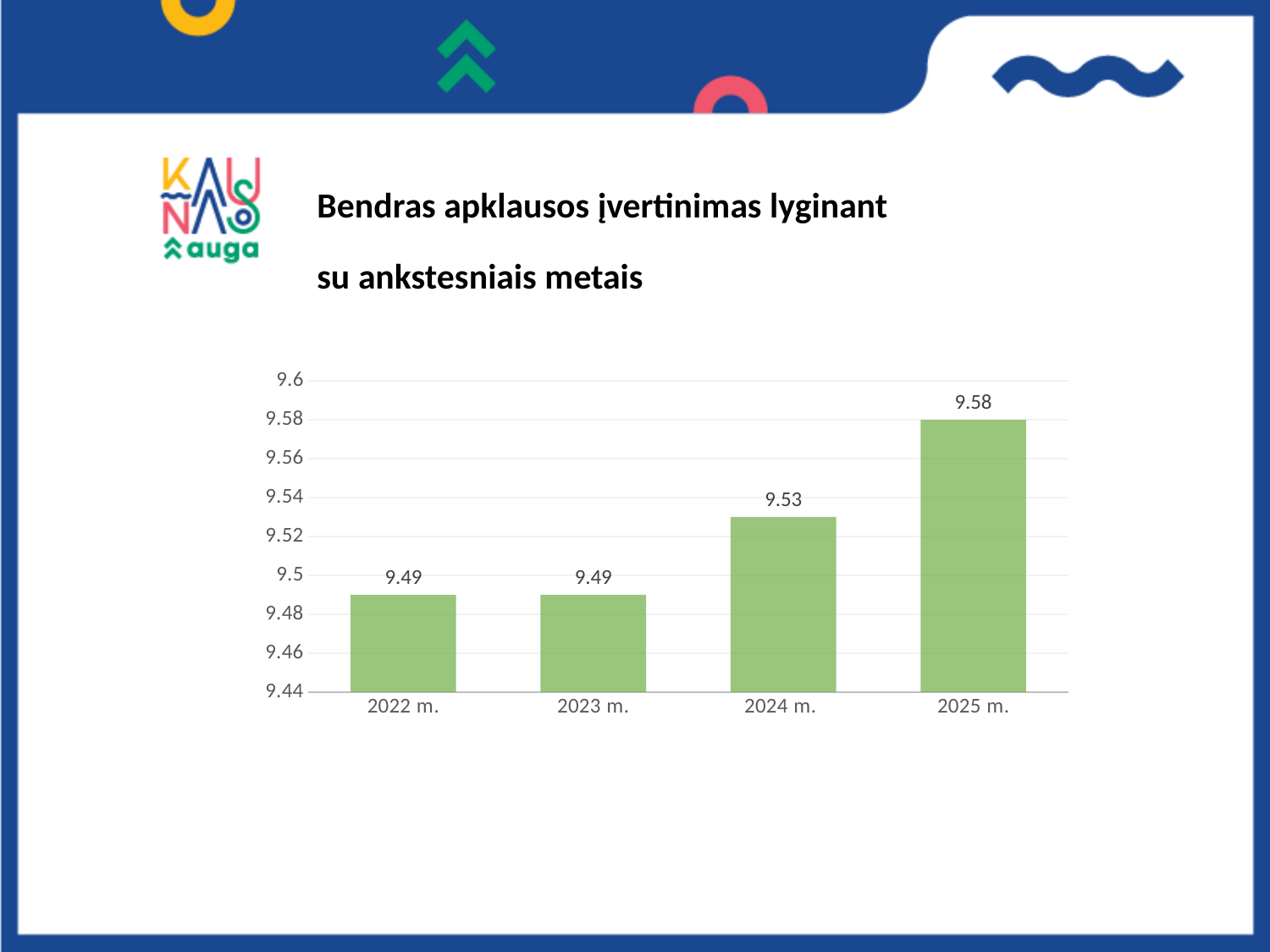
Which year has the highest value? 2025 m. What is the difference between the values for 2025 m. and 2024 m.? 0.05 What is the value for 2024 m.? 9.53 Is the value for 2025 m. greater or less than 9.56? greater How many years are shown on the x axis? 4 Which is larger, the value for 2024 m. or the value for 2023 m.? 2024 m. What is the value for 2025 m.? 9.58 What is the value for 2022 m.? 9.49 What kind of chart is shown on the slide? bar chart Is the value for 2022 m. greater or less than 9.5? less Do the values rise or fall from 2022 m. to 2025 m.? rise What is the difference between the values for 2024 m. and 2023 m.? 0.04